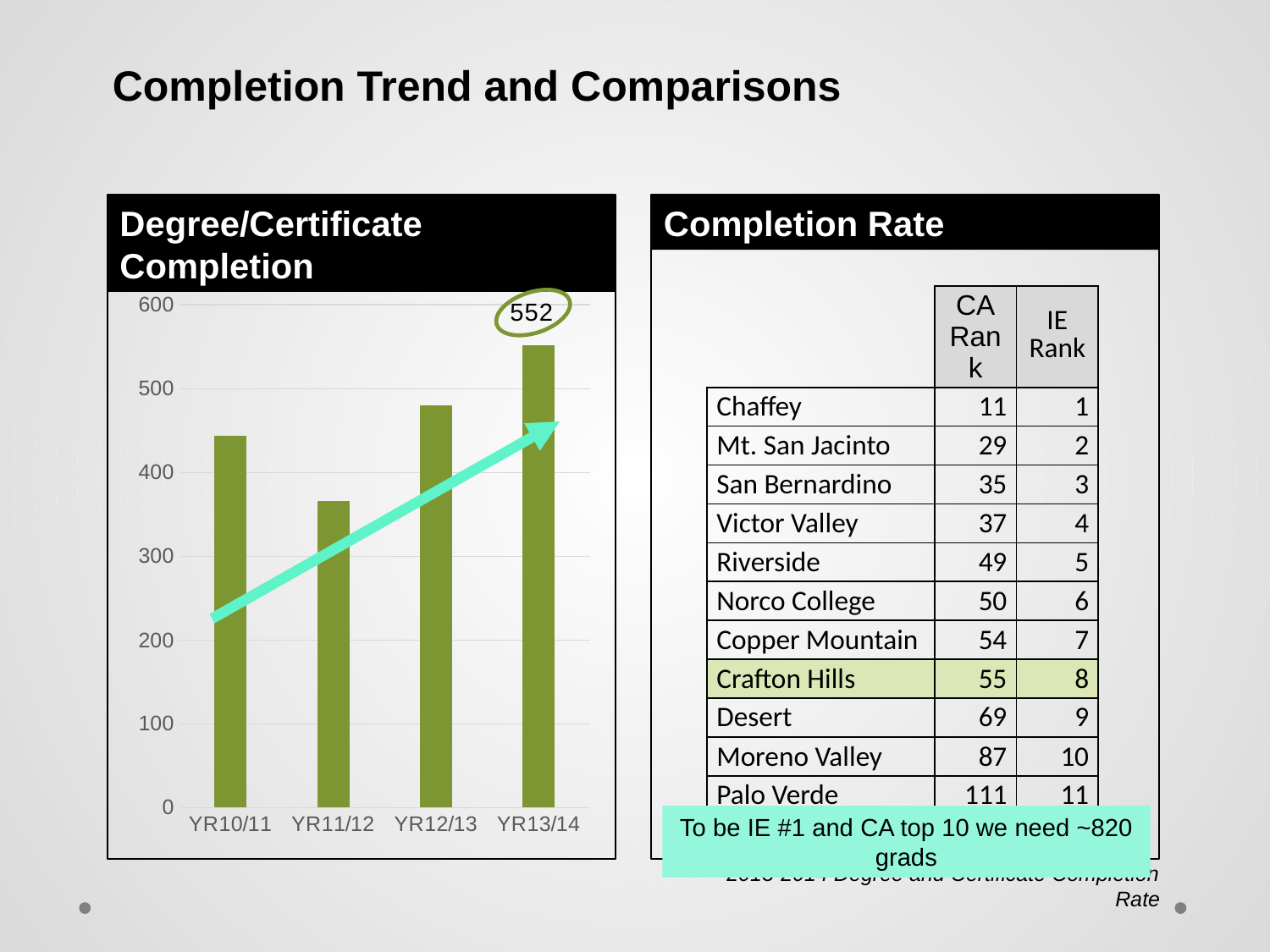
How many years are shown on the x axis of the Degree/Certificate Completion chart? 4 Which year has the lowest value in the Degree/Certificate Completion chart? YR11/12 In the Degree/Certificate Completion chart, which is larger, the value for YR10/11 or YR11/12? YR10/11 What kind of chart is the Degree/Certificate Completion chart? bar chart In the Degree/Certificate Completion chart, which is larger, the value for YR12/13 or YR13/14? YR13/14 In the Degree/Certificate Completion chart, is the value for YR10/11 greater or less than 400? greater Which year has the highest value in the Degree/Certificate Completion chart? YR13/14 What is the value for YR13/14 in the Degree/Certificate Completion chart? 552 In the Degree/Certificate Completion chart, is the value for YR13/14 greater or less than 500? greater In the Degree/Certificate Completion chart, do the values rise or fall from YR11/12 to YR13/14? rise In the Degree/Certificate Completion chart, is the value for YR11/12 greater or less than 400? less